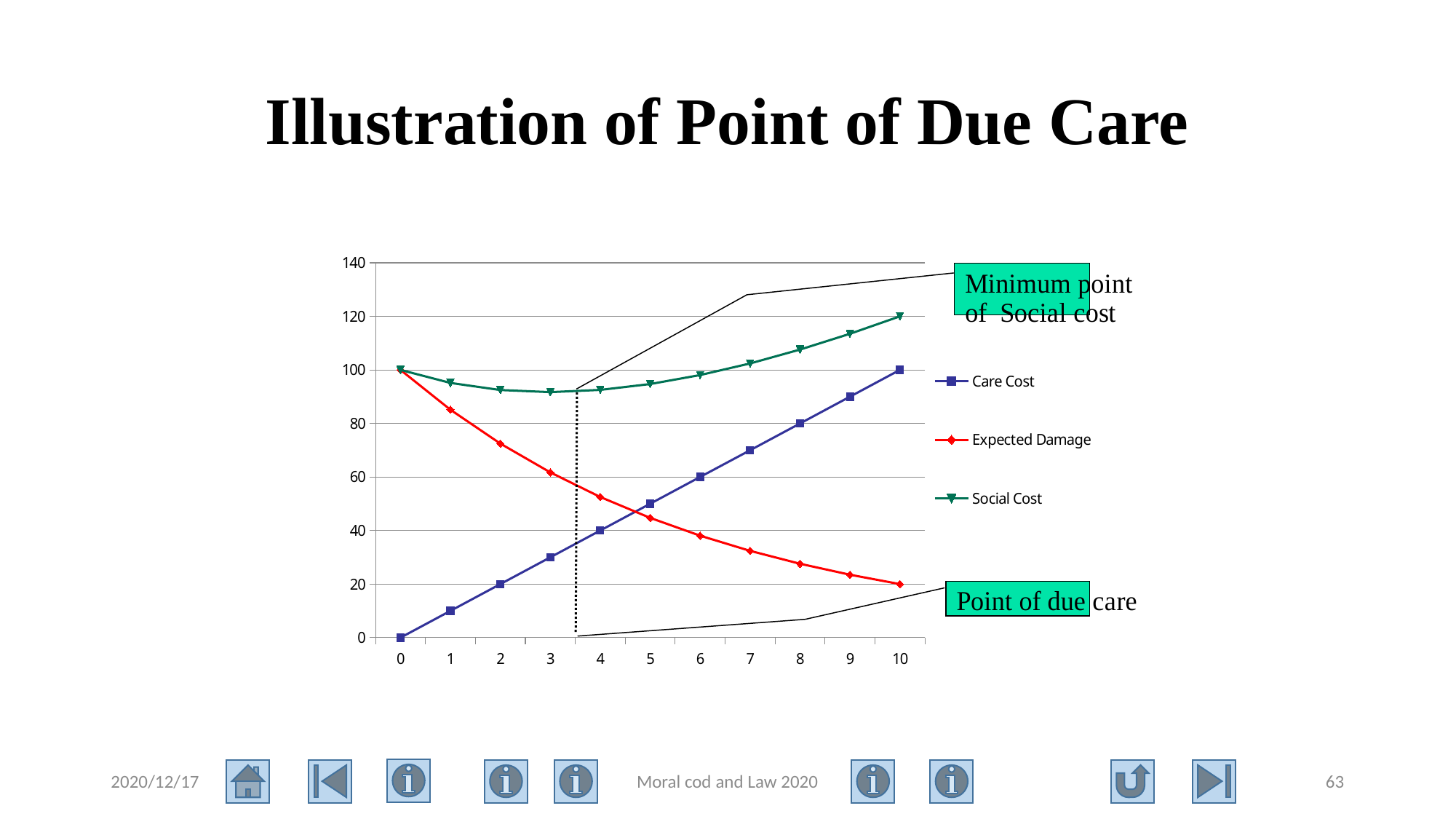
Which series has the highest value at x = 10? Social Cost Is the Social Cost value at x = 3 greater or less than 100? less What kind of chart is shown on the slide? line chart Does the Care Cost series rise or fall as x increases from 0 to 10? rise What is the Care Cost value at x = 4? 40 At x = 8, which is larger: Care Cost or Expected Damage? Care Cost What is the Expected Damage value at x = 0? 100 Does the Expected Damage series rise or fall as x increases from 0 to 10? fall What is the title of the slide containing the chart? Illustration of Point of Due Care What is the Social Cost value at x = 10? 120 How many series does the legend list? 3 What is the Care Cost value at x = 10? 100